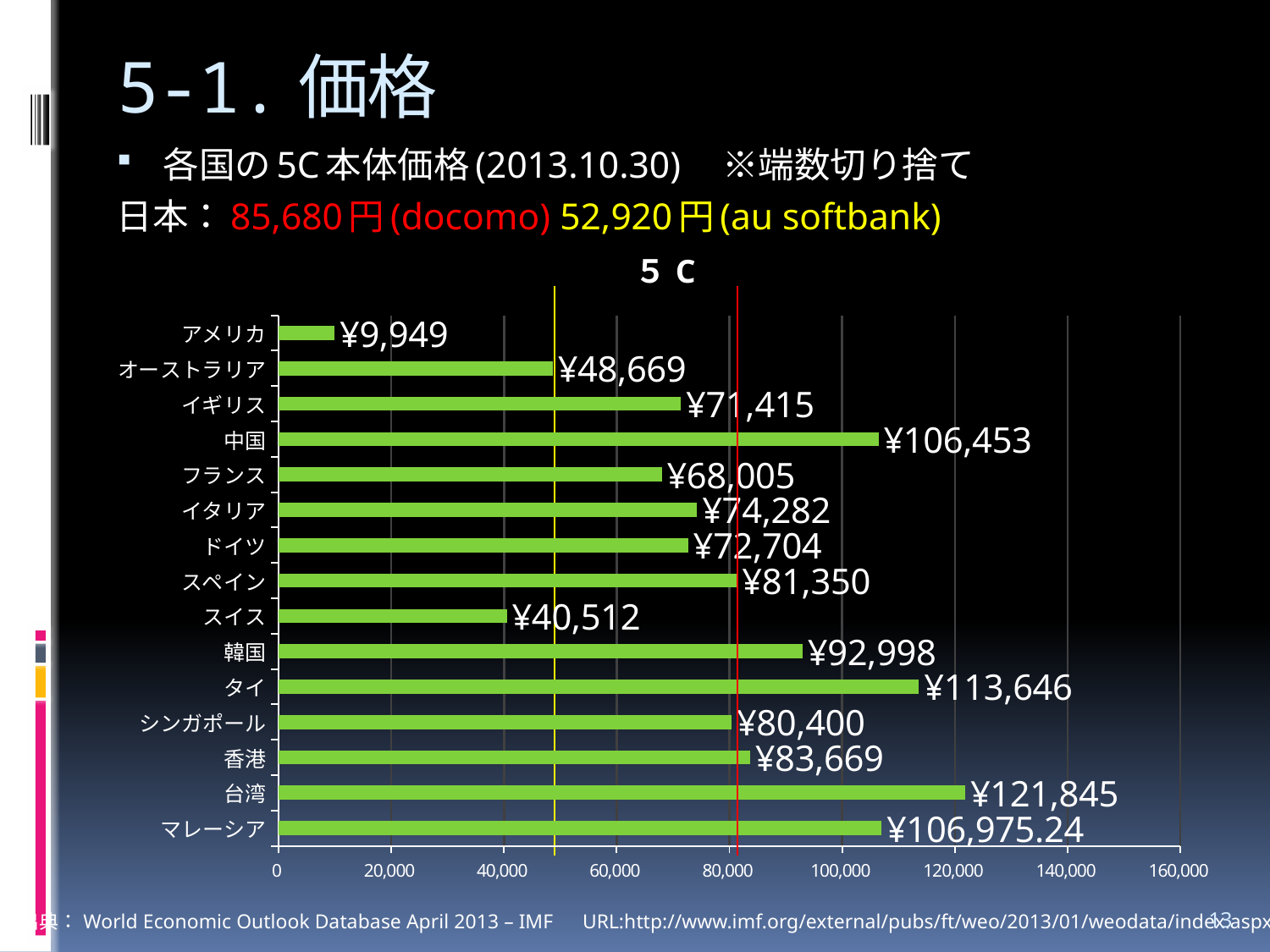
How many categories are shown in the 5C chart? 15 Which has a larger value in the 5C chart, タイ or 韓国? タイ What is the difference between the values for 台湾 and アメリカ in the 5C chart? ¥111,896 What is the difference between the values for 中国 and イギリス in the 5C chart? ¥35,038 What is the value for スイス in the 5C chart? ¥40,512 What is the value for マレーシア in the 5C chart? ¥106,975.24 Which category has the highest value in the 5C chart? 台湾 What is the value for 中国 in the 5C chart? ¥106,453 What kind of chart is shown on the slide? bar chart Is the value for 香港 in the 5C chart greater or less than 80,000? greater Which category has the lowest value in the 5C chart? アメリカ What is the title of the chart on the slide? 5C